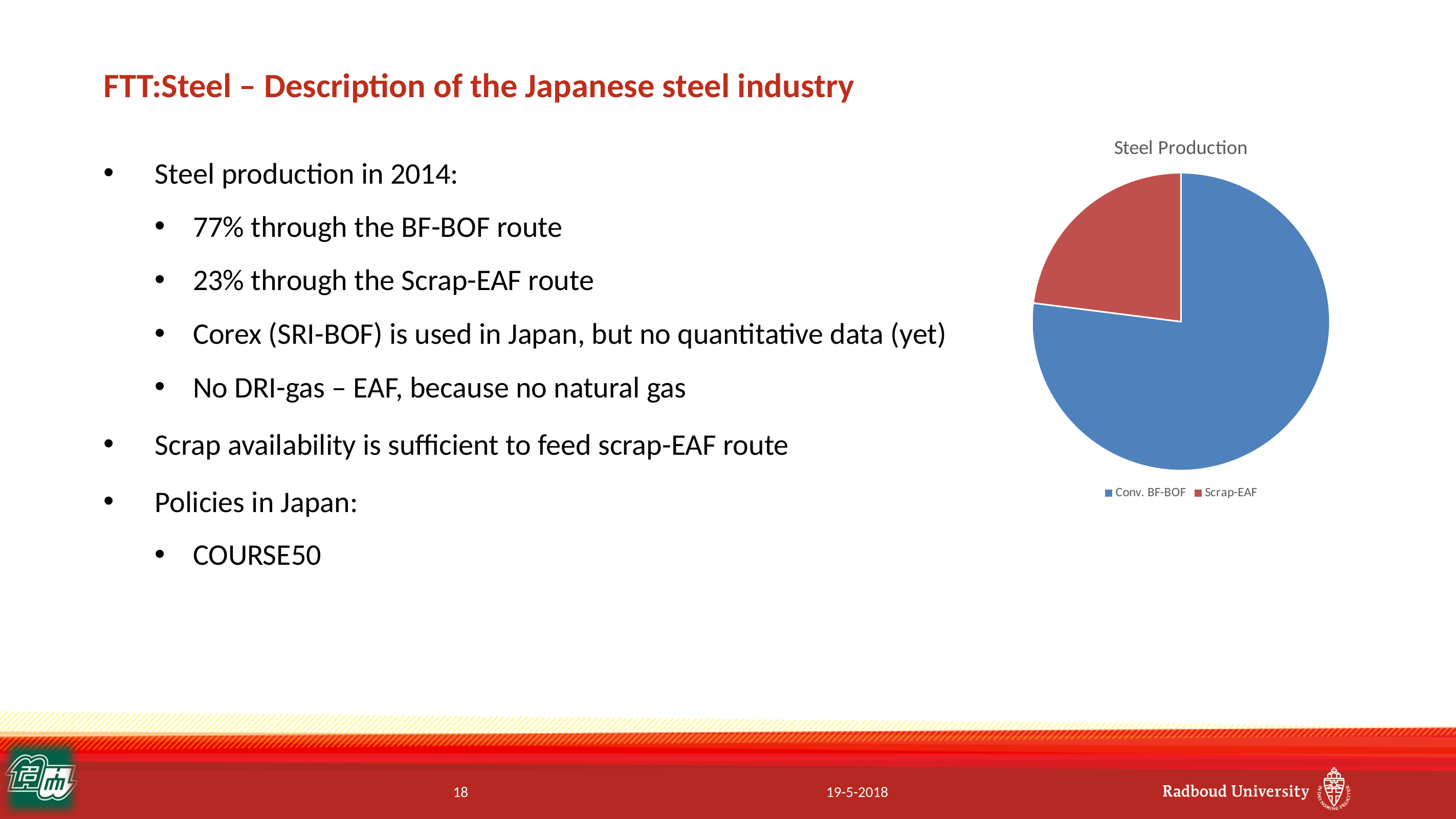
What colour is the Scrap-EAF slice in the pie chart? red How many entries does the chart legend list? 2 Which slice is larger, Conv. BF-BOF or Scrap-EAF? Conv. BF-BOF What share of steel production does the Conv. BF-BOF slice represent? 77% How many slices does the pie chart have? 2 Which category has the smallest slice of the pie chart? Scrap-EAF Which category has the largest slice of the pie chart? Conv. BF-BOF What share of steel production does the Scrap-EAF slice represent? 23% What is the title of the chart? Steel Production What kind of chart is shown on the slide? pie chart